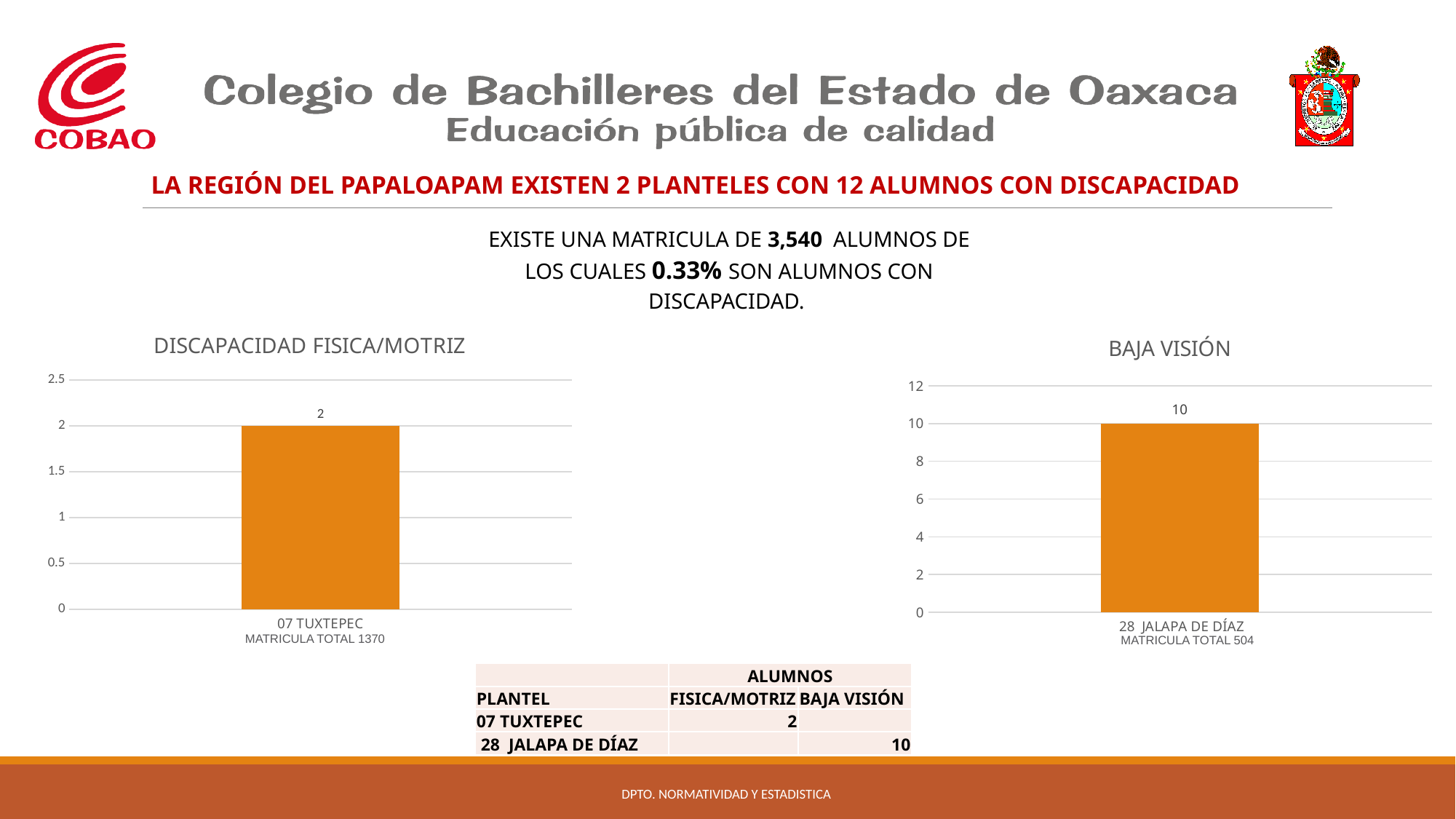
In the 'BAJA VISIÓN' chart, what is the value for 28 JALAPA DE DÍAZ? 10 What is the title of the chart on the right side of the slide? BAJA VISIÓN How many categories are plotted in the 'DISCAPACIDAD FISICA/MOTRIZ' chart? 1 In the 'DISCAPACIDAD FISICA/MOTRIZ' chart, is the value for 07 TUXTEPEC greater or less than 2.5? less What kind of chart is the 'DISCAPACIDAD FISICA/MOTRIZ' chart? bar chart Which is larger: the value for 28 JALAPA DE DÍAZ in the 'BAJA VISIÓN' chart or the value for 07 TUXTEPEC in the 'DISCAPACIDAD FISICA/MOTRIZ' chart? 28 JALAPA DE DÍAZ What is the difference between the value in the 'BAJA VISIÓN' chart and the value in the 'DISCAPACIDAD FISICA/MOTRIZ' chart? 8 How many categories are plotted in the 'BAJA VISIÓN' chart? 1 In the 'BAJA VISIÓN' chart, is the value for 28 JALAPA DE DÍAZ greater or less than 8? greater What is the highest value shown on the y axis of the 'BAJA VISIÓN' chart? 12 In the 'DISCAPACIDAD FISICA/MOTRIZ' chart, what is the value for 07 TUXTEPEC? 2 What kind of chart is the 'BAJA VISIÓN' chart? bar chart